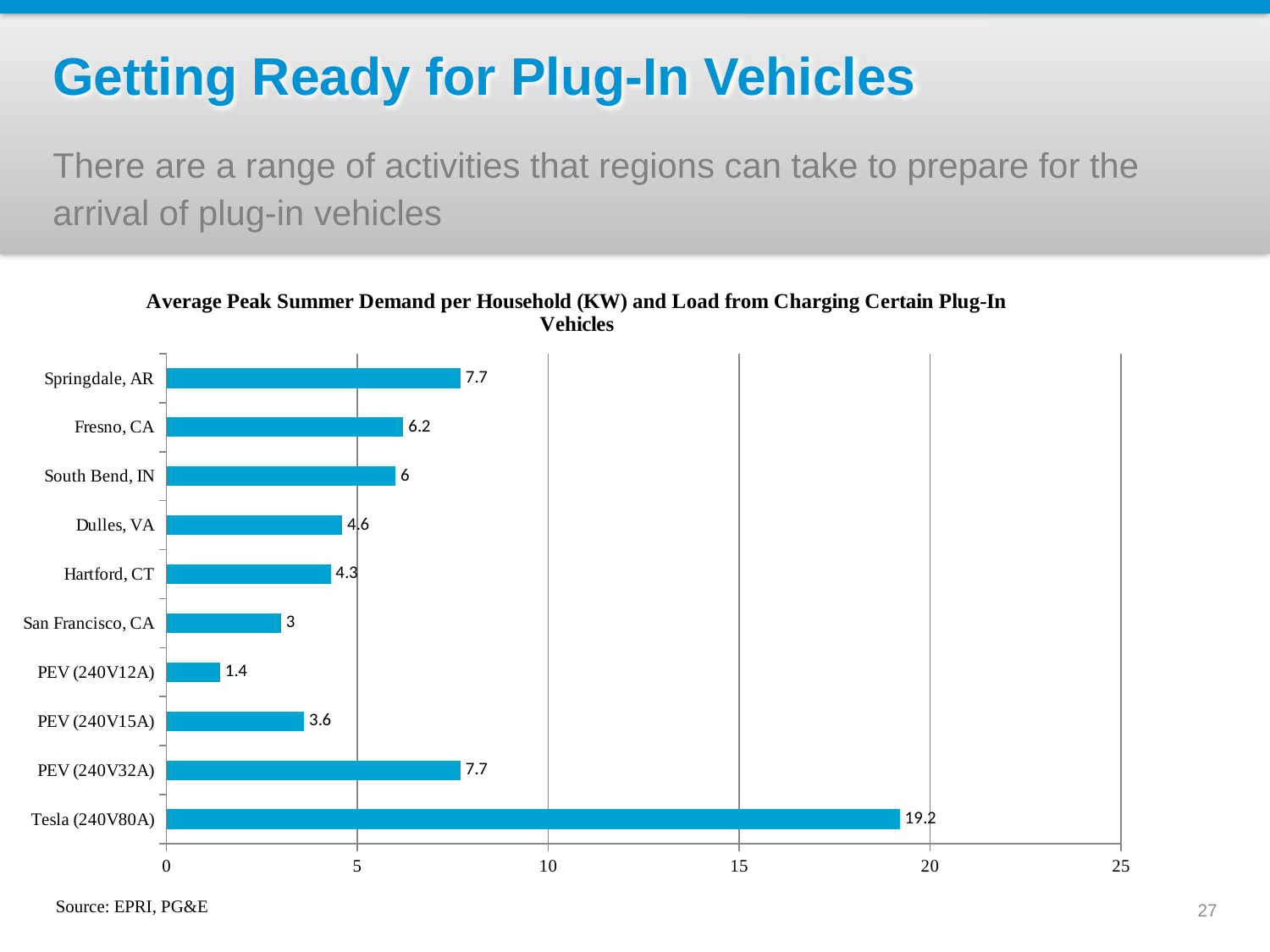
Which is larger, the value for South Bend, IN or the value for Dulles, VA? South Bend, IN What is the value for PEV (240V15A)? 3.6 What is the value for Fresno, CA? 6.2 Is the value for Tesla (240V80A) greater or less than 15? greater What is the value for Hartford, CT? 4.3 What is the difference between the values for Tesla (240V80A) and PEV (240V32A)? 11.5 How many categories are shown in the chart? 10 What is the value for Tesla (240V80A)? 19.2 Which category has the highest value? Tesla (240V80A) What is the difference between the values for Springdale, AR and San Francisco, CA? 4.7 What kind of chart is shown on the slide? Bar chart Which category has the lowest value? PEV (240V12A)